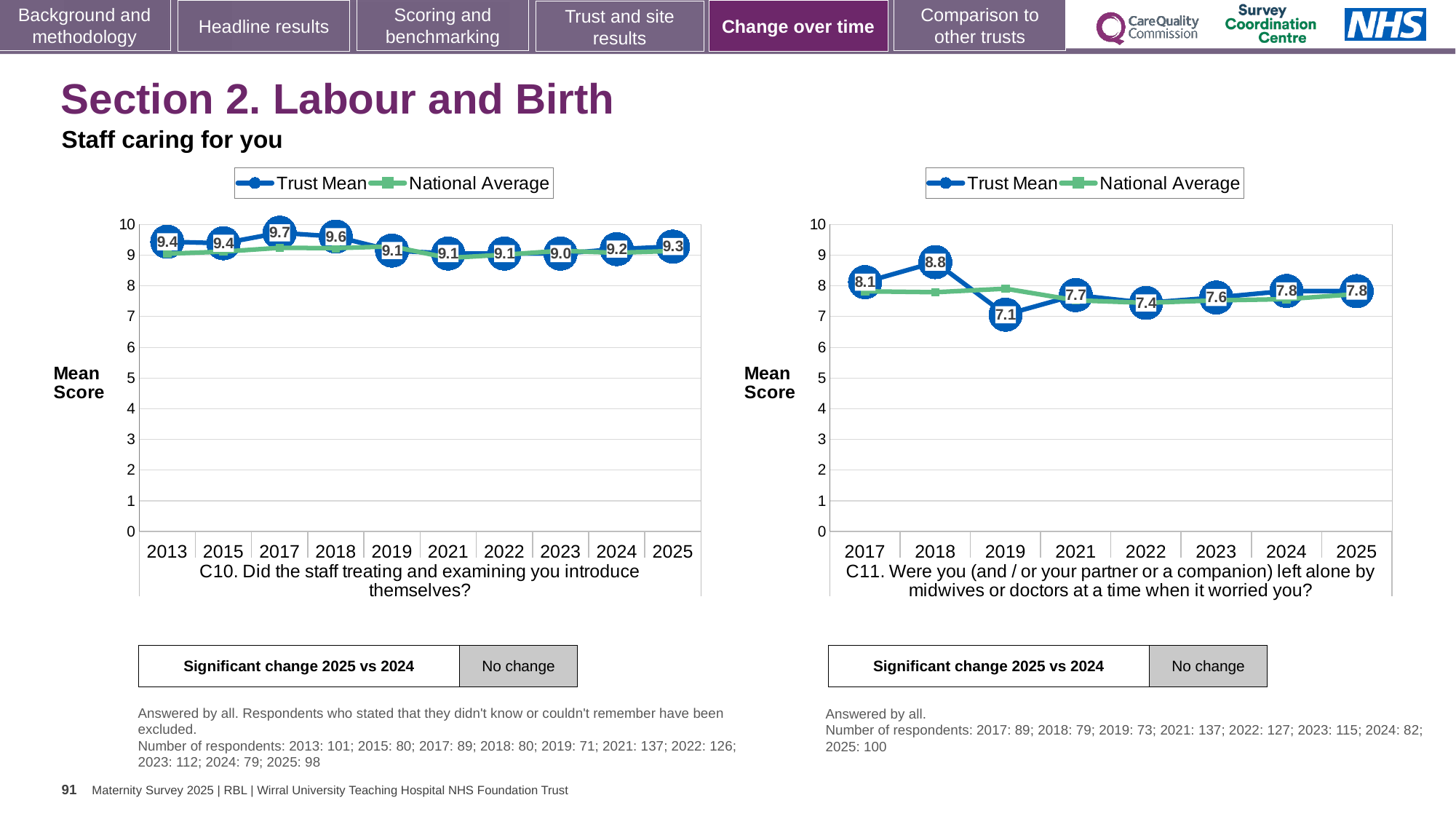
In the C11 chart (right), what is the Trust Mean score for 2019? 7.1 In the C10 chart (left), which year has the highest Trust Mean score? 2017 In the C11 chart (right), is the Trust Mean score for 2018 larger or smaller than the score for 2017? larger In the C10 chart (left), what is the difference between the Trust Mean scores for 2017 and 2023? 0.7 In the C11 chart (right), how many series does the legend list? 2 In the C10 chart (left), which year has the lowest Trust Mean score? 2023 In the C11 chart (right), which year has the lowest Trust Mean score? 2019 In the C11 chart (right), which year has the highest Trust Mean score? 2018 In the C10 chart (left), what is the Trust Mean score for 2017? 9.7 In the C10 chart (left), what is the Trust Mean score for 2025? 9.3 In the C10 chart (left), how many years are plotted on the x axis? 10 What kind of chart is the C11 chart (right)? line chart